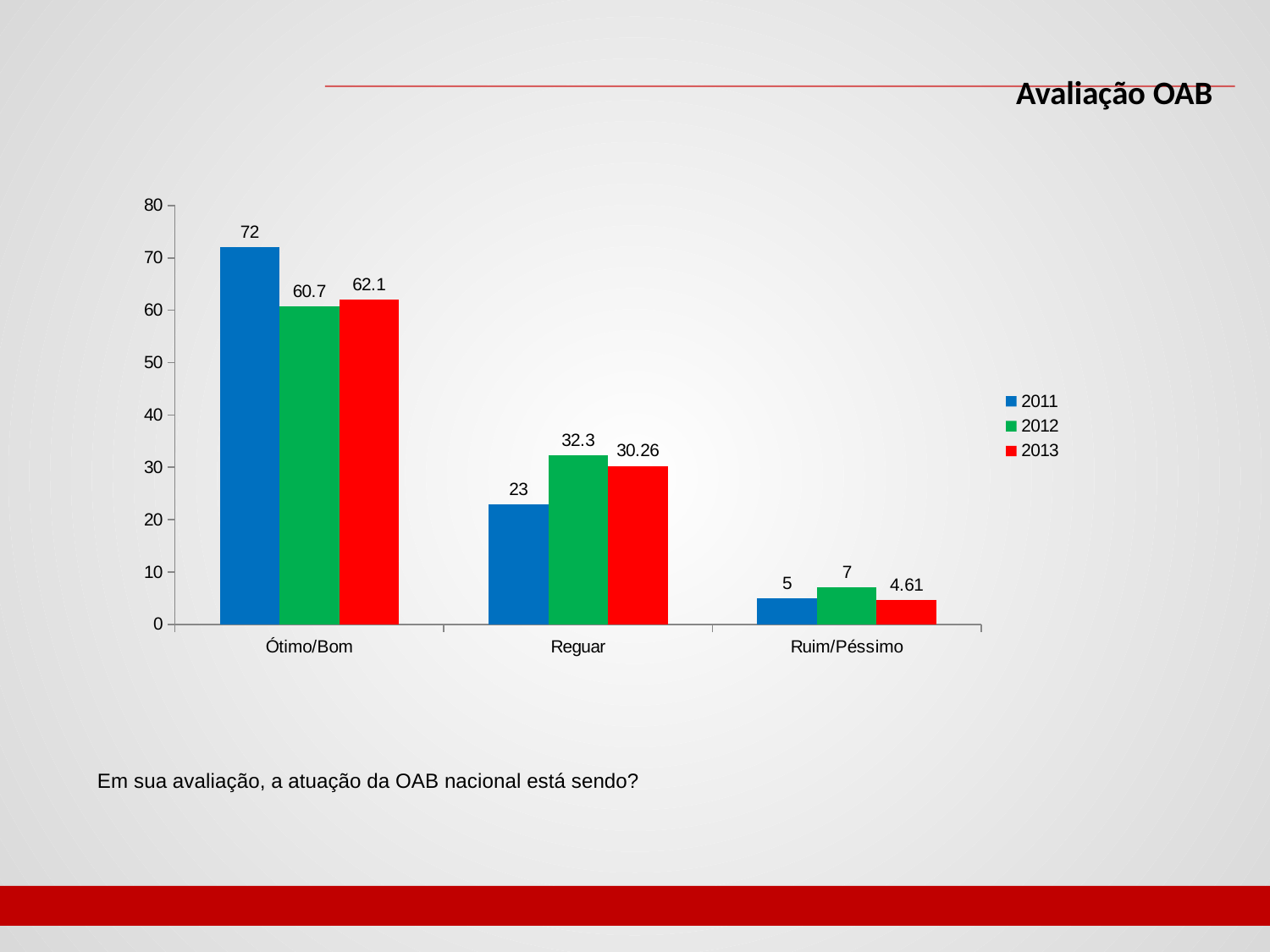
How many categories are shown on the x axis? 3 What is the value for Ruim/Péssimo in 2012? 7 What is the value for Reguar in 2013? 30.26 What is the value for Ótimo/Bom in 2011? 72 Which is larger for Reguar: the 2012 value or the 2011 value? 2012 What is the difference between the 2011 and 2012 values for Ótimo/Bom? 11.3 What is the title of the slide? Avaliação OAB Is the value for Ótimo/Bom in 2013 greater or less than 70? less How many series does the legend list? 3 Which category has the lowest value in the 2013 series? Ruim/Péssimo Which category has the highest value in the 2012 series? Ótimo/Bom What kind of chart is shown on the slide? bar chart